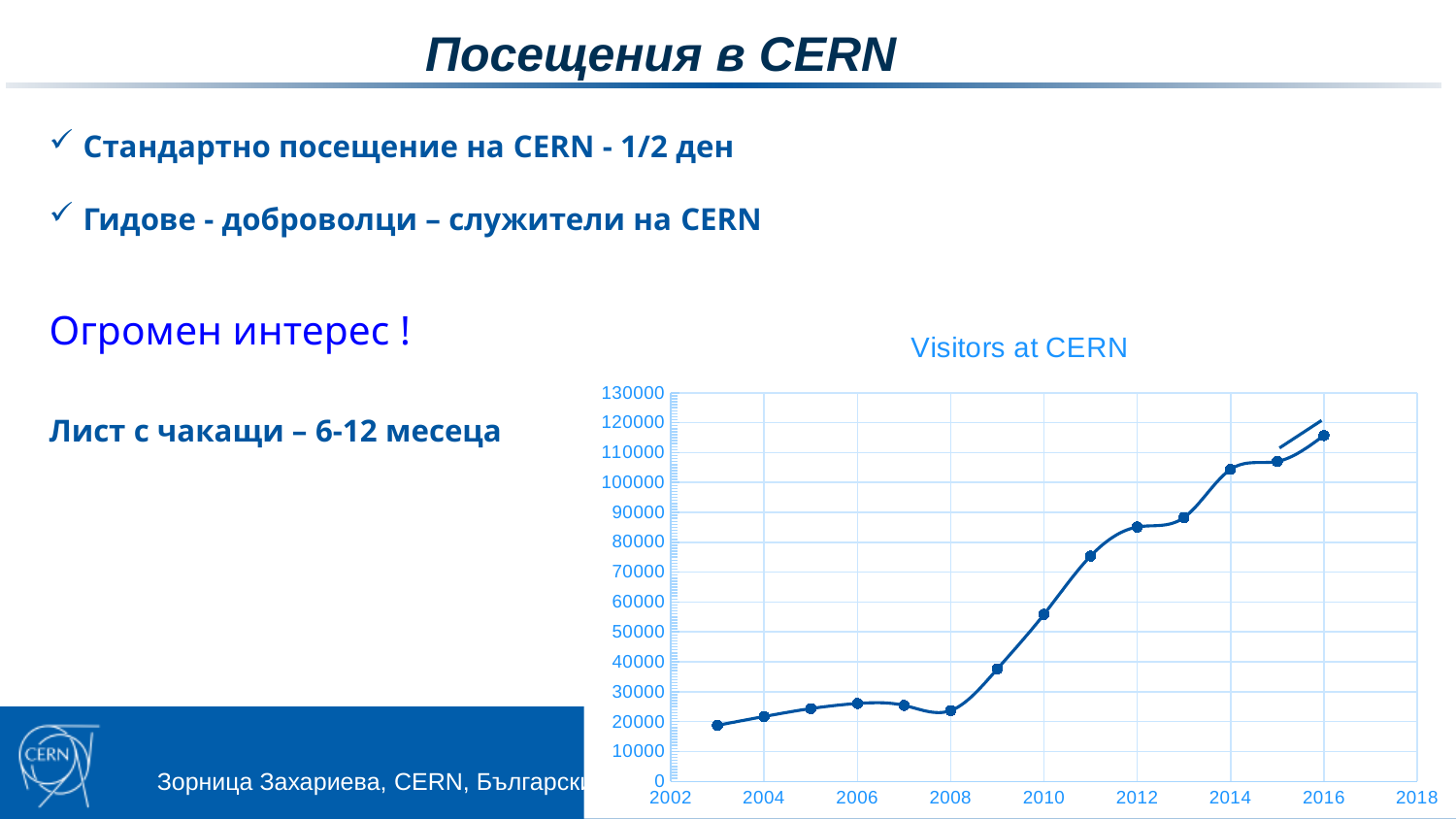
Which is larger, the value for 2010 or the value for 2008? 2010 How many data points are plotted in the Visitors at CERN chart? 14 Do the values in the Visitors at CERN chart generally rise or fall from 2003 to 2016? rise Is the value for 2008 greater or less than 30000? less Is the value for 2009 greater or less than 40000? less What kind of chart is shown on the slide? line chart Which year has the lowest value in the Visitors at CERN chart? 2003 Is the value for 2016 greater or less than 110000? greater What is the title of the chart? Visitors at CERN Which year has the highest value in the Visitors at CERN chart? 2016 Which is larger, the value for 2014 or the value for 2012? 2014